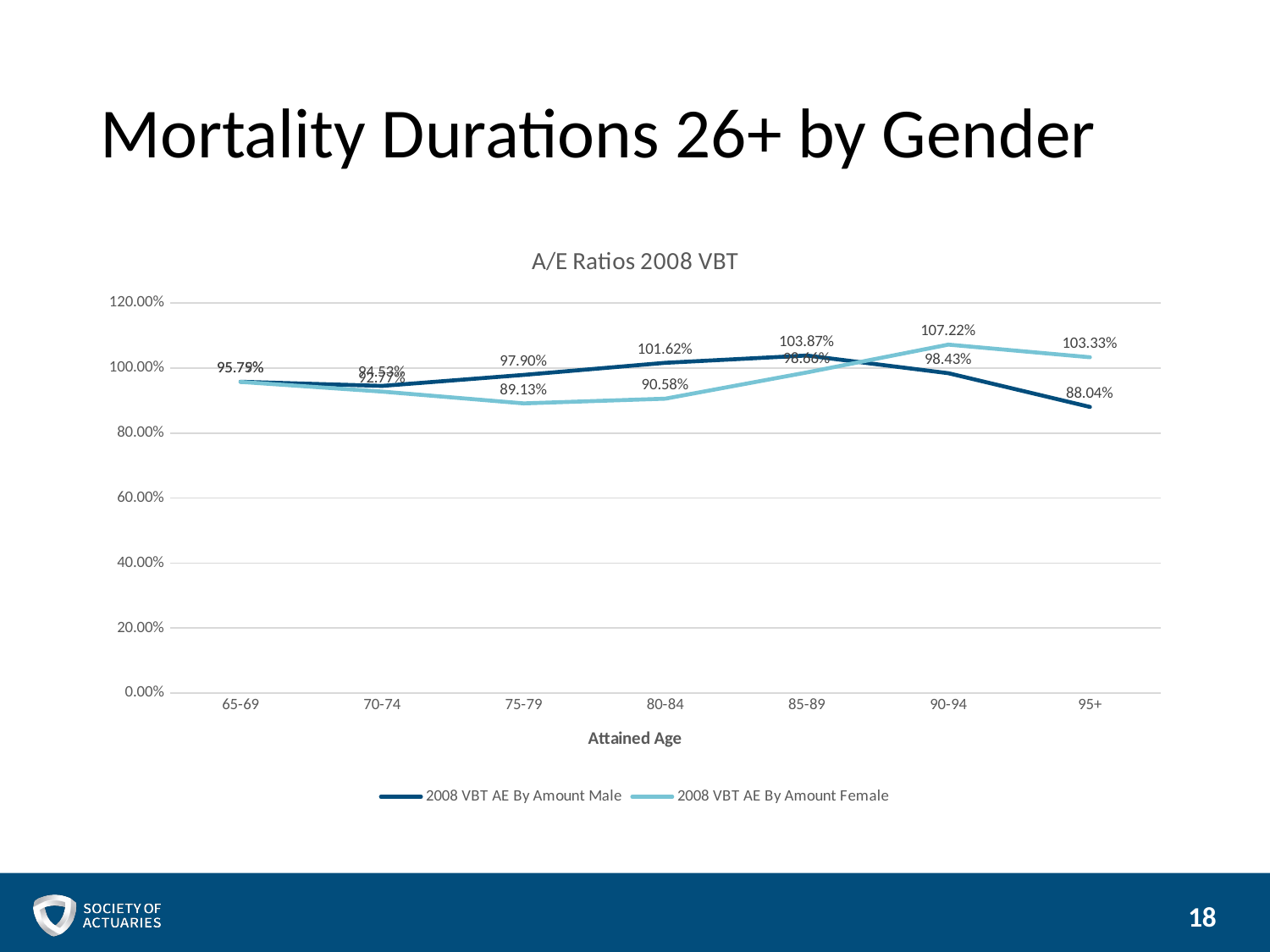
What is the 2008 VBT AE By Amount Female value for attained age 90-94? 107.22% What type of chart is shown on the slide? Line chart What is the 2008 VBT AE By Amount Female value for attained age 80-84? 90.58% At which attained age is the 2008 VBT AE By Amount Male value lowest? 95+ What is the 2008 VBT AE By Amount Male value for attained age 95+? 88.04% At which attained age is the 2008 VBT AE By Amount Female value highest? 90-94 At attained age 95+, which series has the higher value, Male or Female? Female What is the 2008 VBT AE By Amount Male value for attained age 75-79? 97.90% At which attained age is the 2008 VBT AE By Amount Male value highest? 85-89 What is the difference between the Male and Female values at attained age 80-84? 11.04 percentage points Is the 2008 VBT AE By Amount Female value for attained age 75-79 greater or less than 100.00%? less How many attained age categories are shown on the x axis? 7